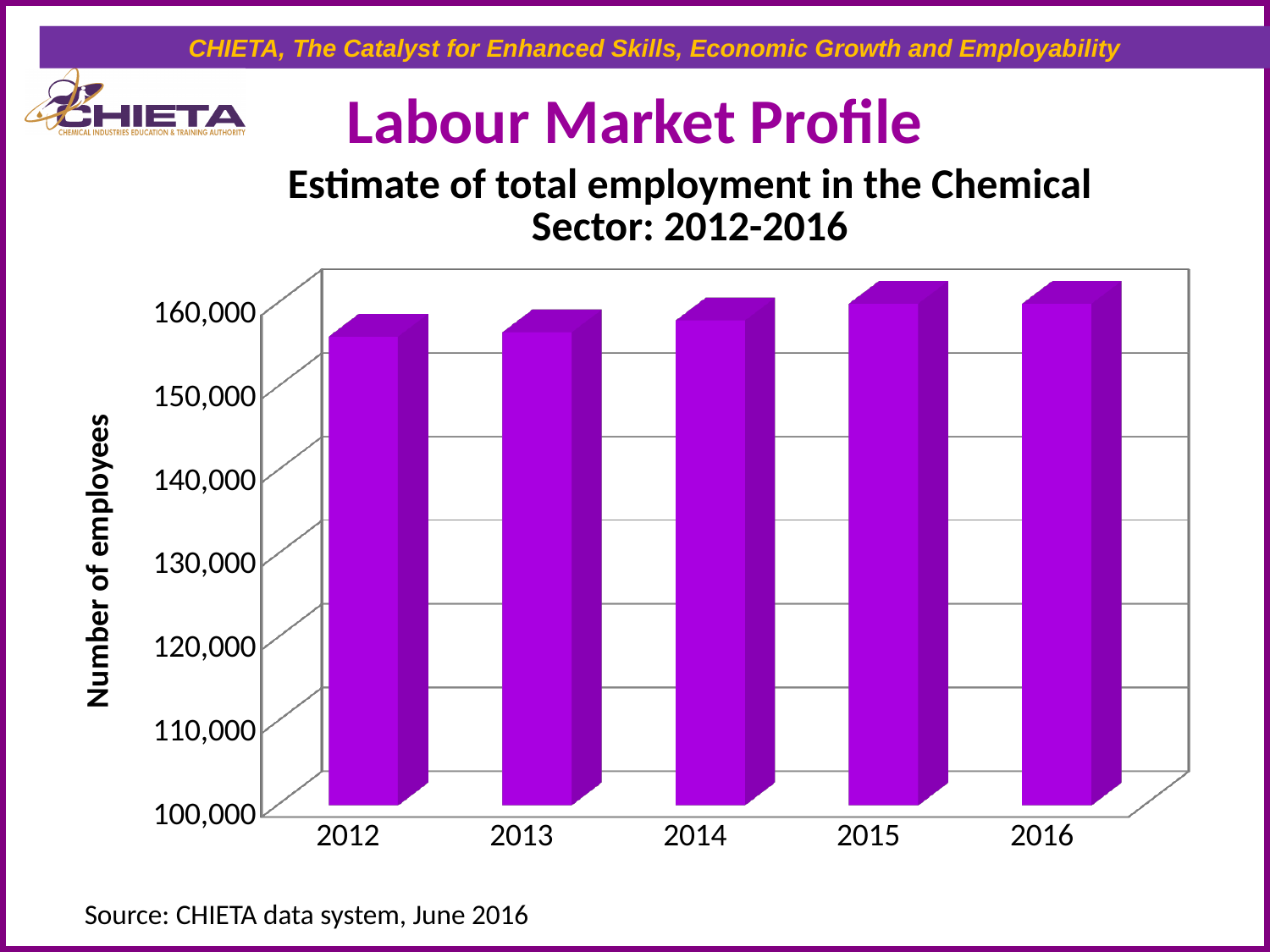
How many years are shown on the x axis of the chart? 5 Is the value for 2014 greater or less than 160,000? less Which is larger, the value for 2013 or the value for 2015? 2015 What is the title of the chart? Estimate of total employment in the Chemical Sector: 2012-2016 Do the values rise or fall from 2012 to 2015? rise What kind of chart is shown on the slide? bar chart Is the value for 2013 greater or less than 150,000? greater Is the value for 2012 greater or less than 160,000? less Which is larger, the value for 2012 or the value for 2015? 2015 Which year has the lowest estimated employment in the chart? 2012 What is the label on the vertical axis of the chart? Number of employees